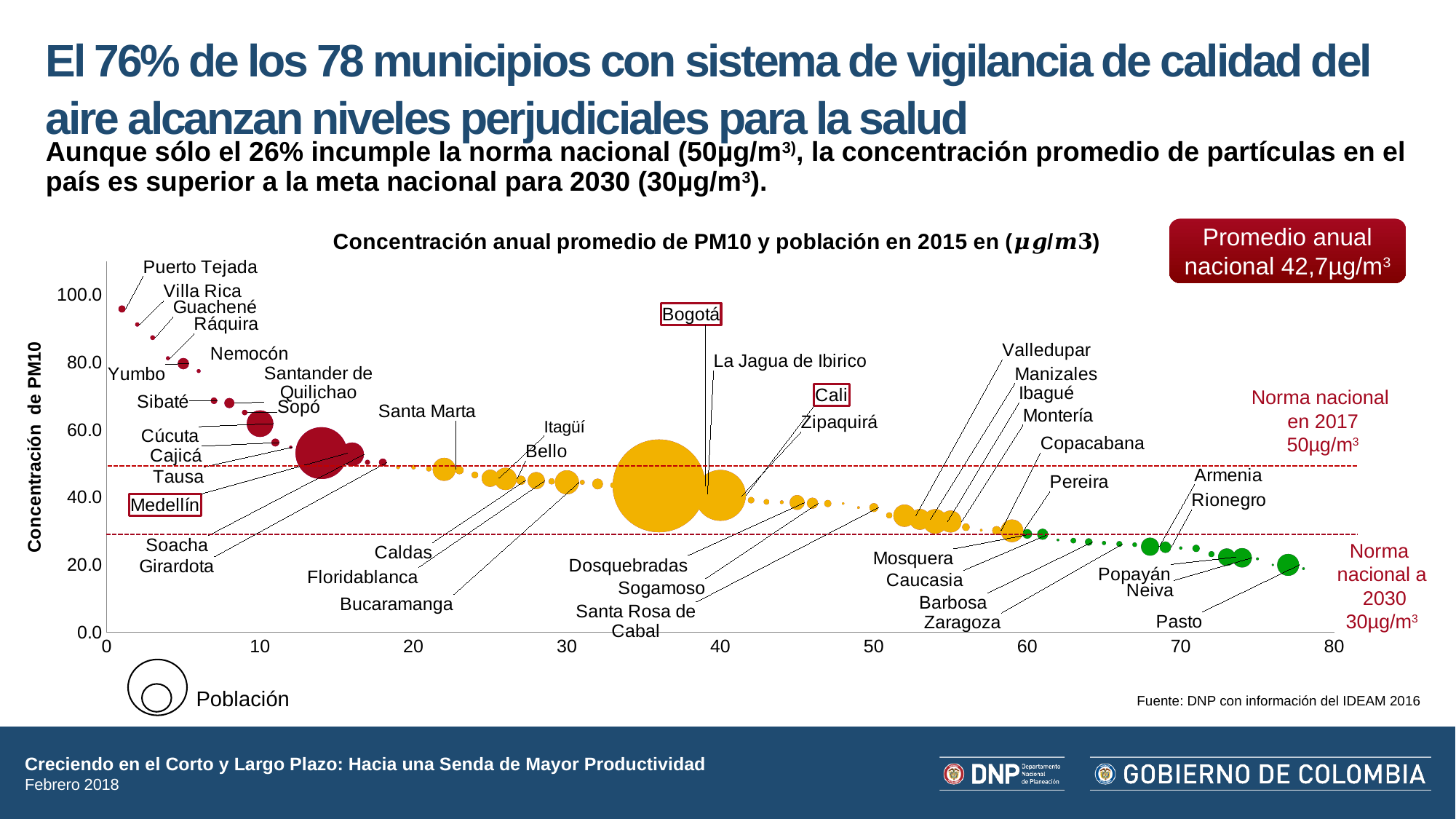
Which has a higher PM10 concentration, Medellín or Bogotá? Medellín Which municipality has the highest PM10 concentration in the chart? Puerto Tejada What kind of chart is shown on the slide? bubble chart Is the PM10 concentration for Puerto Tejada greater or less than 80? greater Is the PM10 concentration for Bogotá greater or less than 60? less What value is marked for the 'Norma nacional en 2017' reference line? 50μg/m³ Which municipality is shown with the largest bubble (largest population)? Bogotá Which municipality has the lowest PM10 concentration in the chart? Pasto What is the title of the chart? Concentración anual promedio de PM10 y población en 2015 en (μg/m3) What does the size of each bubble represent, according to the legend? Población What is the 'Promedio anual nacional' shown on the slide? 42,7μg/m³ Is the PM10 concentration for Pasto greater or less than 30? less